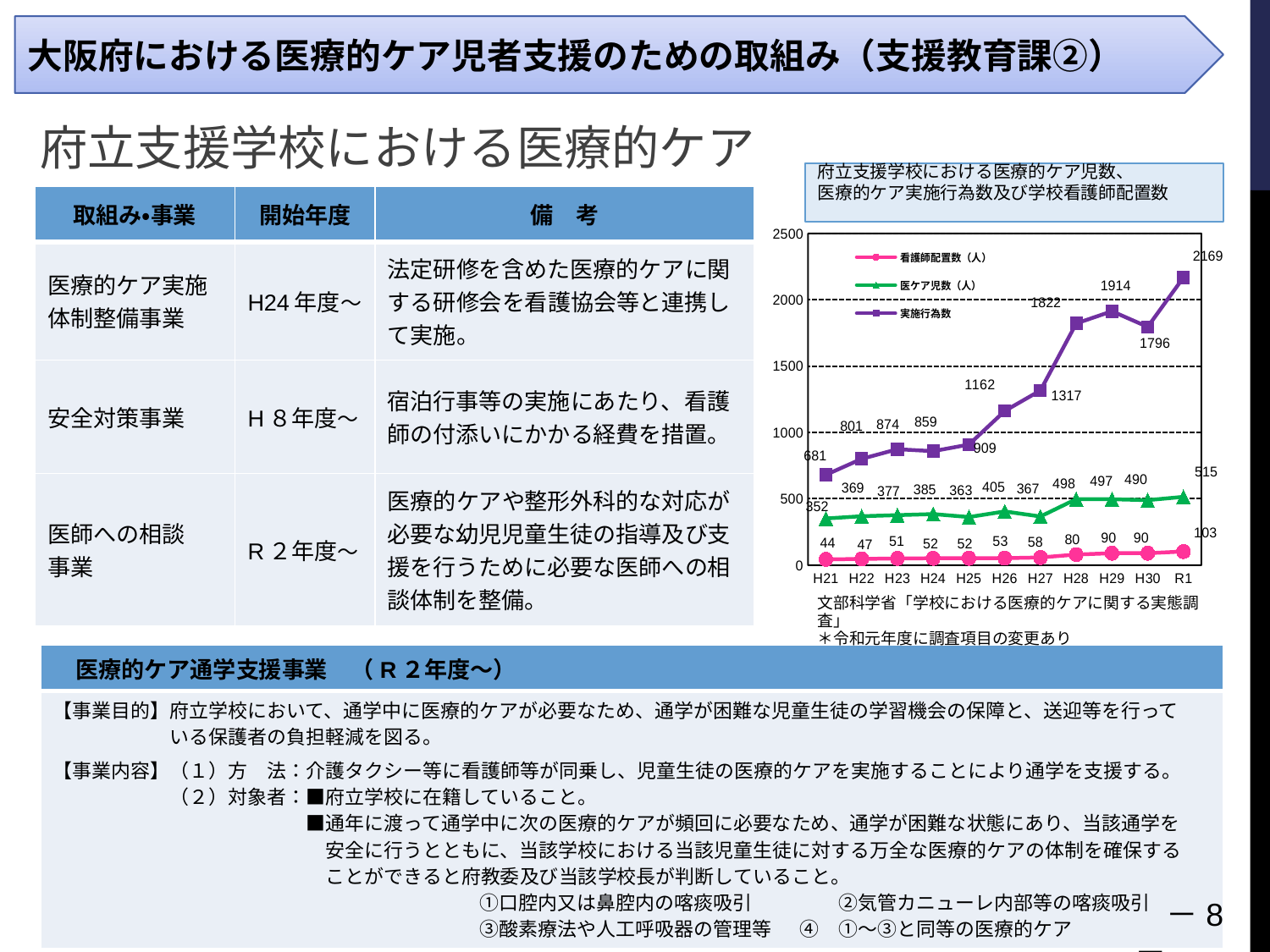
Which is larger: 実施行為数 in H29 or in H30? H29 In which year is 看護師配置数（人） lowest? H21 Does 看護師配置数（人） generally rise or fall from H21 to R1? rise What is the value of 看護師配置数（人） in H21? 44 What is the value of 医ケア児数（人） in H25? 363 What is the difference between 実施行為数 in R1 and in H21? 1488 What type of chart is shown on the slide? line chart What is the value of 医ケア児数（人） in H28? 498 What is the value of 実施行為数 in R1? 2169 In which year is 実施行為数 highest? R1 How many years (points) are plotted along the x axis of the chart? 11 How many series does the chart legend list? 3